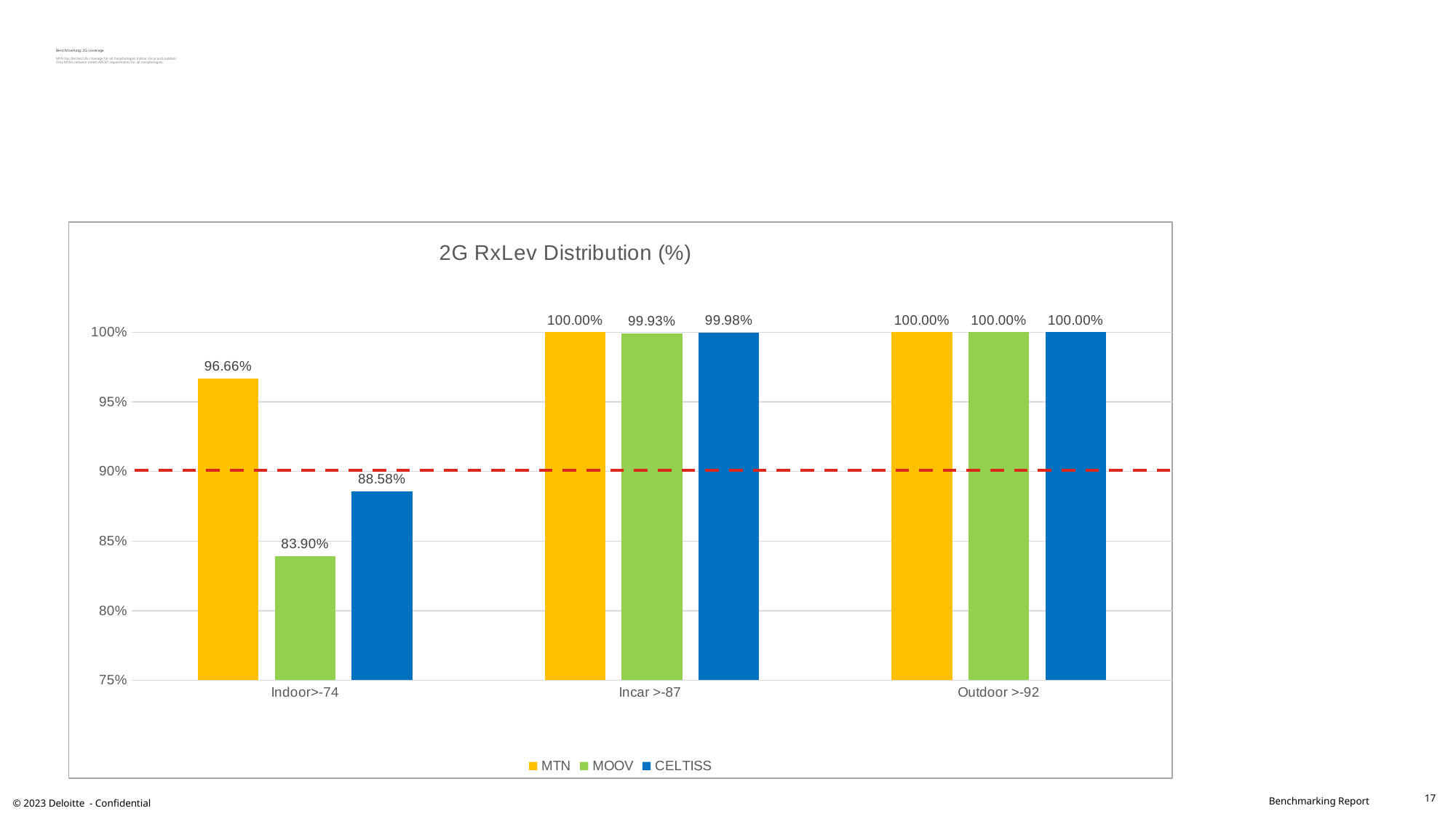
What is the title of the chart? 2G RxLev Distribution (%) What is the value for CELTISS in the Incar >-87 category? 99.98% What is the difference between MTN and CELTISS in the Indoor>-74 category? 8.08% What is the value for MOOV in the Incar >-87 category? 99.93% What is the value for MOOV in the Indoor>-74 category? 83.90% How many categories are shown on the x axis? 3 Is the value for CELTISS in the Indoor>-74 category greater or less than 90%? less Which is larger in the Indoor>-74 category: CELTISS or MOOV? CELTISS How many series does the legend list? 3 Which operator has the lowest value in the Indoor>-74 category? MOOV What is the value for MTN in the Indoor>-74 category? 96.66% Which operator has the highest value in the Indoor>-74 category? MTN